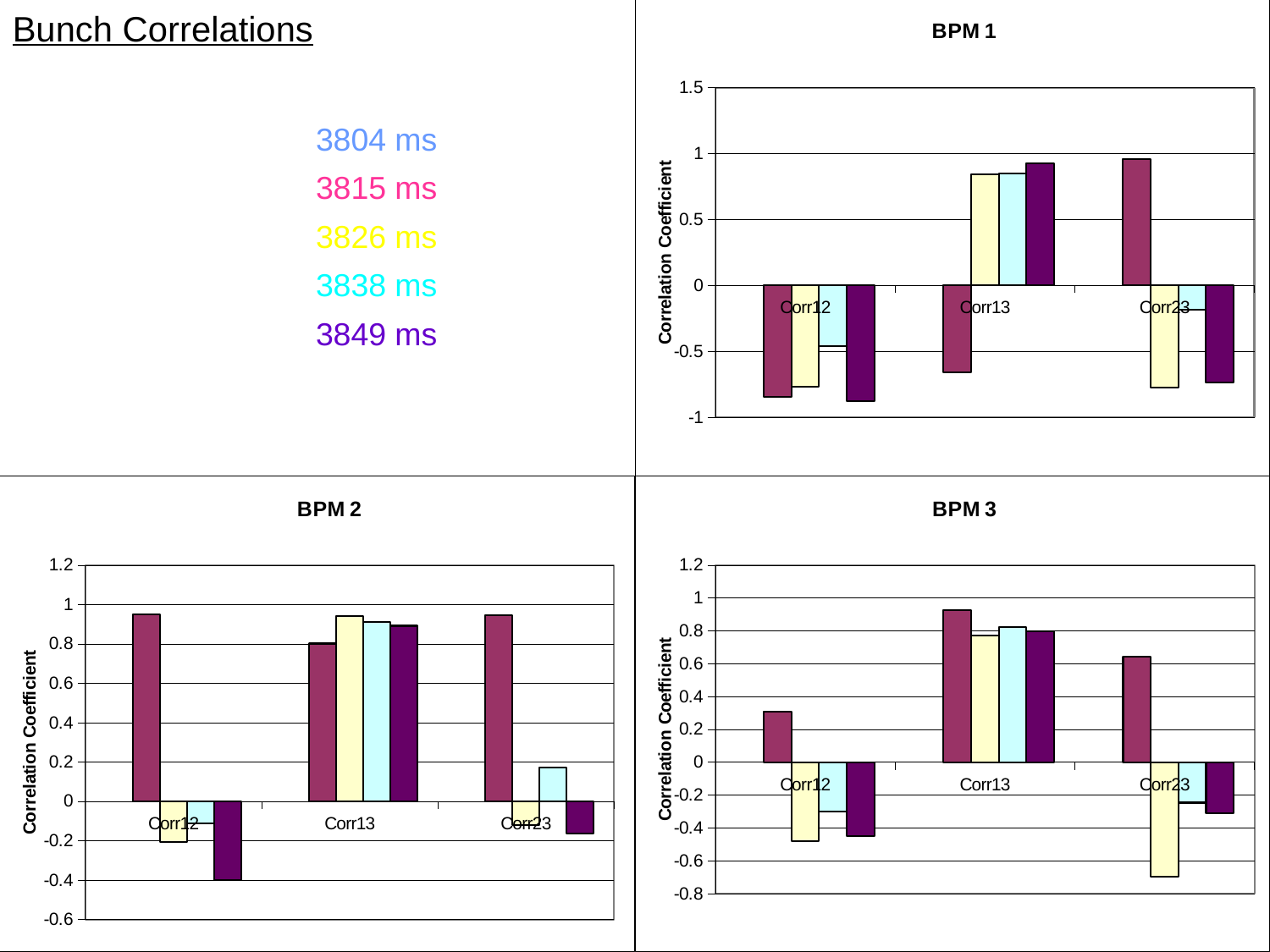
In the BPM 1 chart, which bar in the Corr13 group has the lowest value? the maroon bar In the BPM 3 chart, is the value of the yellow bar for Corr23 greater or less than -0.6? less What is the y-axis title of the BPM 3 chart? Correlation Coefficient In the BPM 2 chart, is the value of the purple bar for Corr12 greater or less than -0.2? less In the BPM 3 chart, is the value of the maroon bar for Corr12 greater or less than 0.2? greater In the BPM 2 chart, which is larger: the maroon bar for Corr12 or the maroon bar for Corr13? Corr12 What kind of chart is the BPM 1 chart? bar chart How many categories are shown on the x axis of the BPM 2 chart? 3